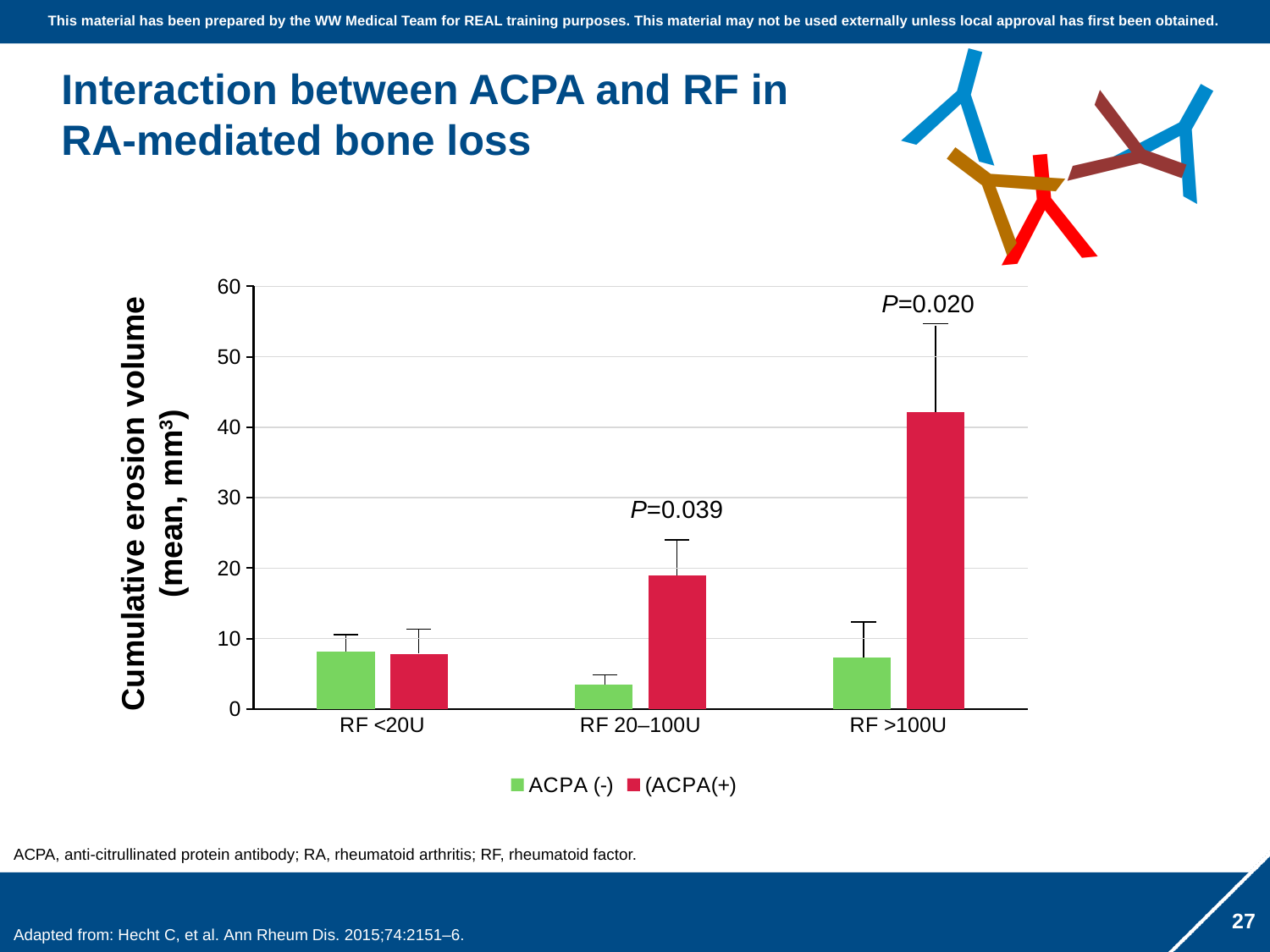
Which bar is the highest on the chart? ACPA(+) at RF >100U Is the value for ACPA (-) at RF 20–100U greater or less than 10? less How many RF categories are shown on the x axis? 3 Do the ACPA(+) values rise or fall as RF increases from RF <20U to RF >100U? rise What kind of chart is shown on the slide? bar chart Is the value for ACPA(+) at RF 20–100U greater or less than 10? greater Is the value for ACPA(+) at RF >100U greater or less than 30? greater What P value is shown above the RF >100U bars? P=0.020 Which bar is the lowest on the chart? ACPA (-) at RF 20–100U In the RF >100U group, which is larger, the ACPA (-) bar or the ACPA(+) bar? ACPA(+) How many series does the legend list? 2 In the RF 20–100U group, which is larger, the ACPA (-) bar or the ACPA(+) bar? ACPA(+)